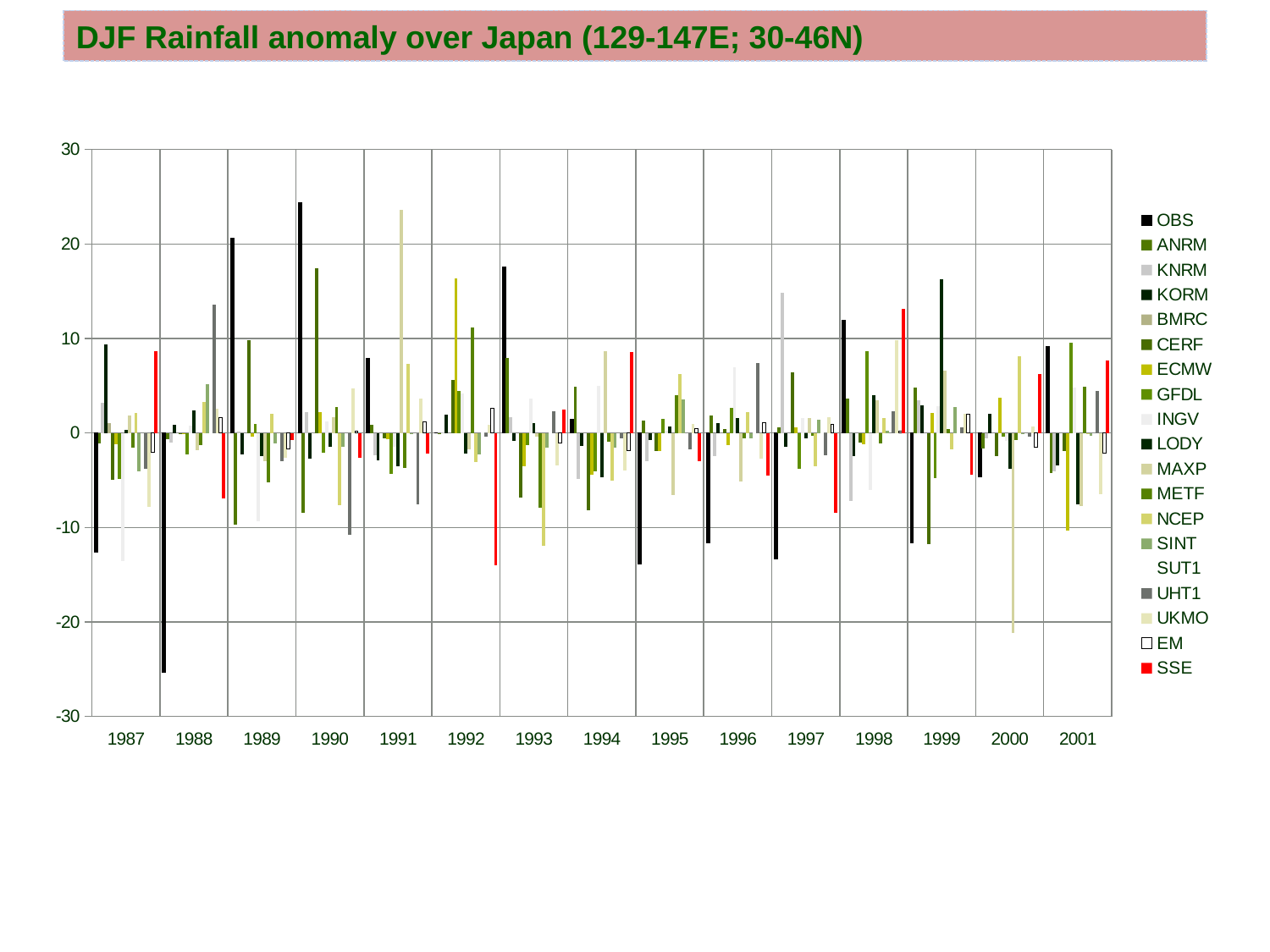
Is the MAXP value for 1991 greater or less than 20? greater Is the OBS value for 1990 greater or less than 20? greater What kind of chart is shown on the slide? bar chart Is the OBS value for 1988 greater or less than -20? less In which year is the OBS bar lowest? 1988 Which is larger, the OBS value for 1990 or the OBS value for 1989? 1990 How many years are shown along the x axis? 15 What is the title of the chart? DJF Rainfall anomaly over Japan (129-147E; 30-46N) How many series does the legend list? 19